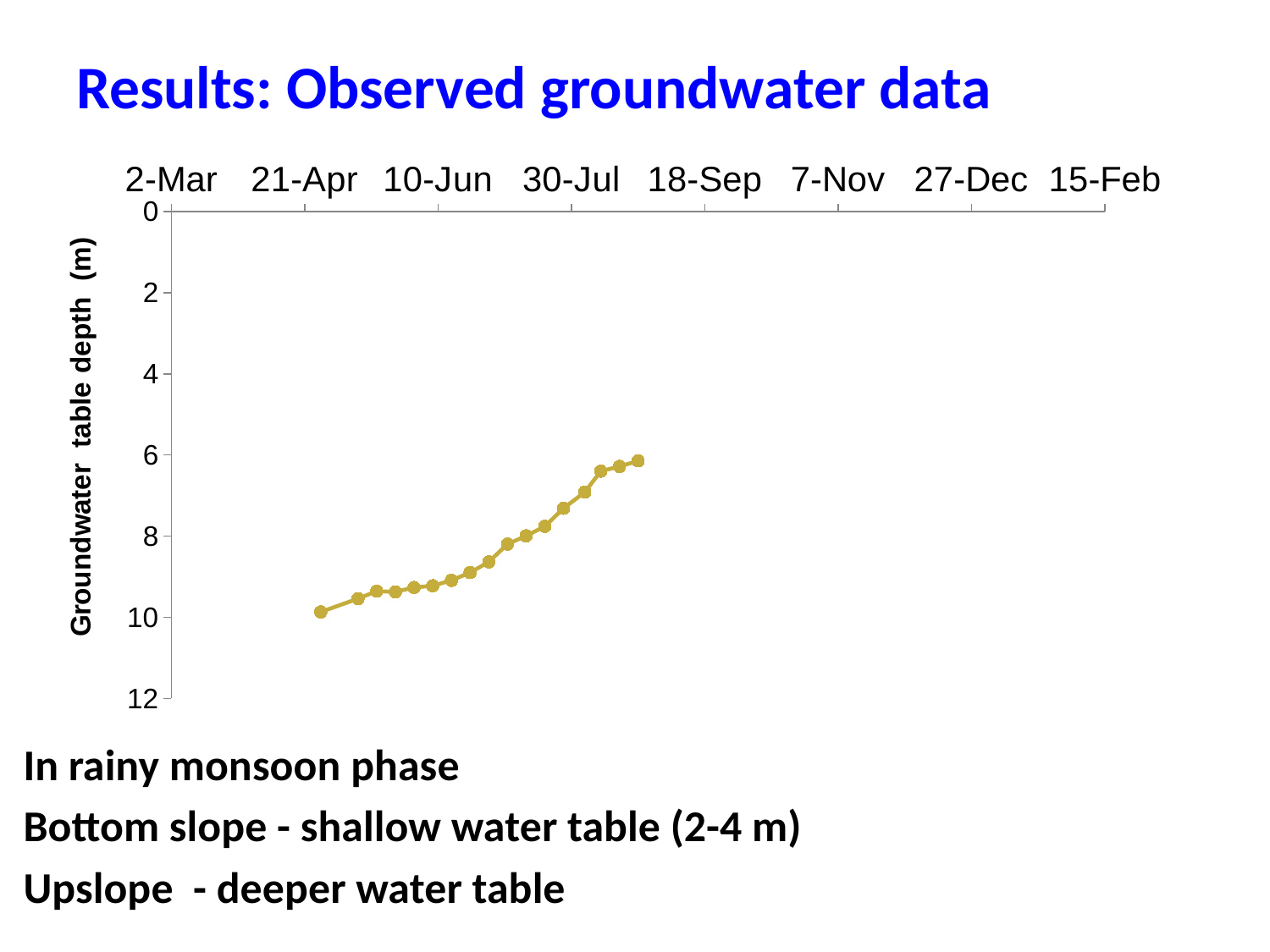
What is the largest value shown on the vertical axis of the chart? 12 How many data series (lines) are plotted on the chart? 1 What is the title of the vertical axis of the chart? Groundwater table depth (m) Which date label appears first (leftmost) on the horizontal axis? 2-Mar Do the plotted groundwater table depth values rise or fall as the dates progress along the x axis? fall What kind of chart is shown on the slide? line chart What is the title of the slide above the chart? Results: Observed groundwater data Which plotted point has the greatest groundwater table depth: the earliest or the latest? the earliest Is the groundwater table depth at the latest plotted point greater or less than 8? less Is the groundwater table depth at the earliest plotted point greater or less than 8? greater How many date labels are shown along the horizontal axis of the chart? 8